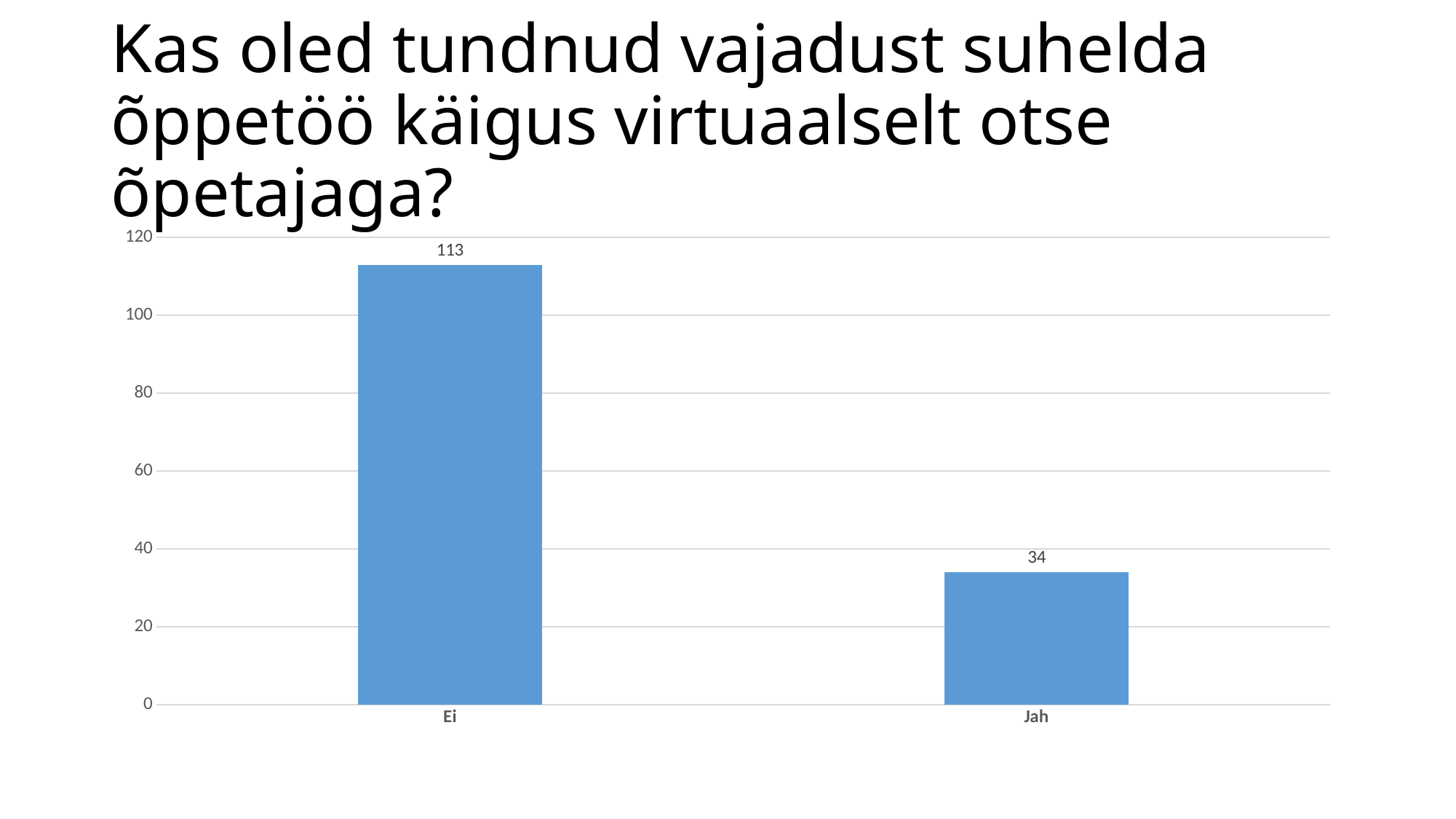
Which category has the highest value? Ei What is the value for Ei? 113 How many categories are shown on the chart? 2 Which is larger, the value for Ei or the value for Jah? Ei What is the difference between the values for Ei and Jah? 79 What is the total of the values for Ei and Jah? 147 Is the value for Ei greater or less than 100? greater Is the value for Jah greater or less than 40? less Which category has the lowest value? Jah What is the highest value shown on the vertical axis? 120 What kind of chart is shown on the slide? bar chart What is the value for Jah? 34